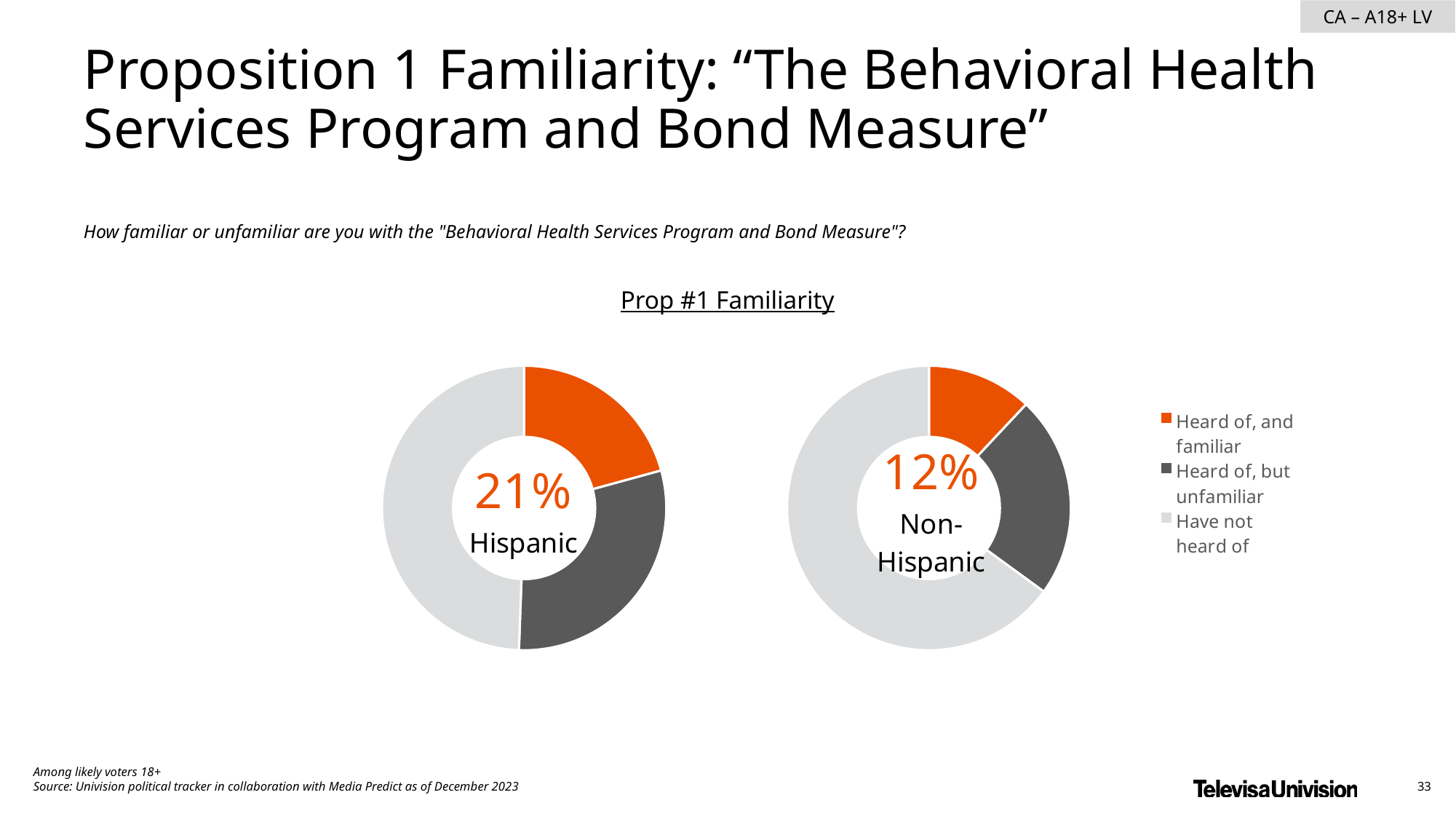
In the Non-Hispanic chart, what percentage have heard of and are familiar with the measure? 12% In the Hispanic chart, which category has the largest slice? Have not heard of Which colour represents 'Heard of, but unfamiliar' in the charts? Dark gray What is the title shown above the two charts? Prop #1 Familiarity In the Non-Hispanic chart, which category has the largest slice? Have not heard of In the Non-Hispanic chart, which category has the smallest slice? Heard of, and familiar How many slices does the Hispanic chart have? 3 What is the difference in percentage points between the Hispanic and Non-Hispanic 'Heard of, and familiar' shares? 9 percentage points In the Hispanic chart, what percentage have heard of and are familiar with the measure? 21% How many entries does the legend list? 3 What kind of chart is used to show the Hispanic and Non-Hispanic familiarity data? Donut (pie) chart Which group has the larger share that has heard of and is familiar with the measure, Hispanic or Non-Hispanic? Hispanic